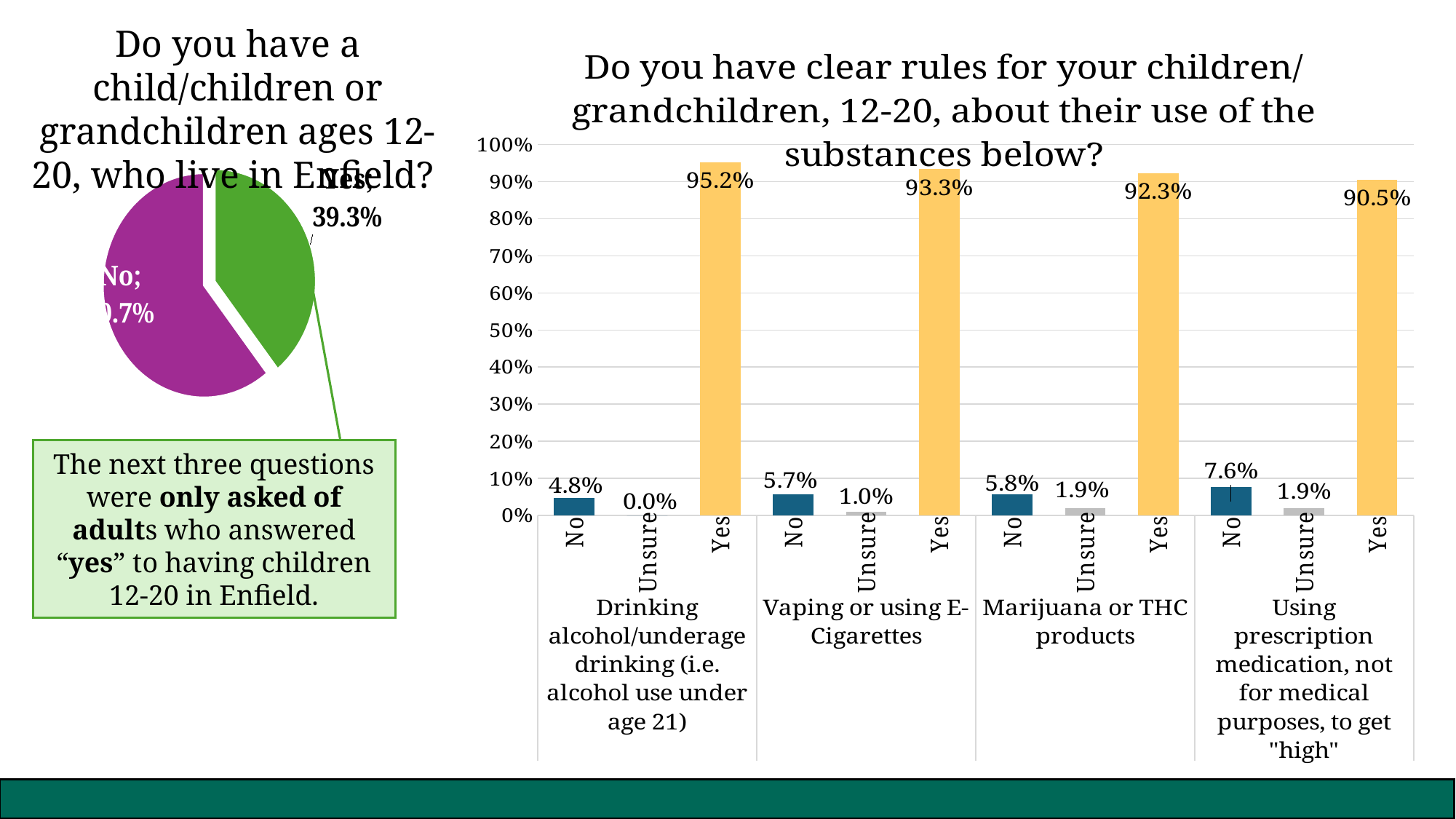
How many substance categories are shown in the bar chart on the right? 4 In the bar chart on the right, what percentage answered Yes for Drinking alcohol/underage drinking? 95.2% In the bar chart on the right, is the No percentage higher for Vaping or using E-Cigarettes or for Using prescription medication to get "high"? Using prescription medication, not for medical purposes, to get "high" In the bar chart on the right, what percentage answered Unsure for Vaping or using E-Cigarettes? 1.0% In the bar chart on the right, which substance has the lowest Yes percentage? Using prescription medication, not for medical purposes, to get "high" In the pie chart on the left, what percentage of respondents answered Yes? 39.3% In the bar chart on the right, what is the Unsure percentage for Drinking alcohol/underage drinking? 0.0% In the bar chart on the right, what is the difference between the Yes percentages for Drinking alcohol/underage drinking and Using prescription medication to get "high"? 4.7% In the bar chart on the right, which substance has the highest Yes percentage? Drinking alcohol/underage drinking (i.e. alcohol use under age 21) In the bar chart on the right, what percentage answered No for Using prescription medication, not for medical purposes, to get "high"? 7.6% What type of chart is the chart on the left of the slide? Pie chart In the bar chart on the right, what percentage answered Yes for Marijuana or THC products? 92.3%